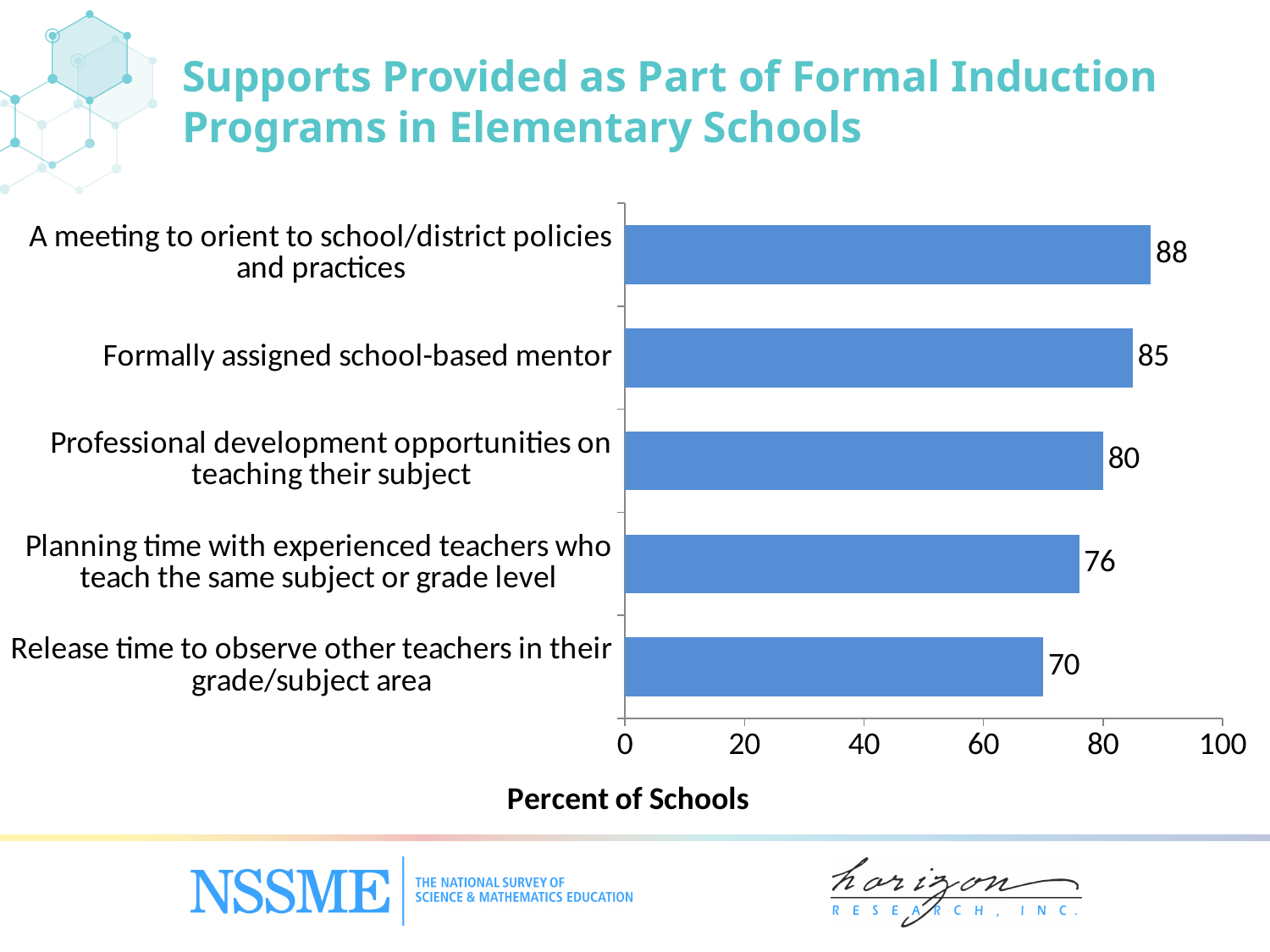
How many supports (categories) are shown in the chart? 5 What kind of chart is shown on the slide? Bar chart What percent of schools provide a formally assigned school-based mentor as part of formal induction programs? 85 What is the label of the horizontal axis? Percent of Schools Which is larger: the value for 'Professional development opportunities on teaching their subject' or the value for 'Planning time with experienced teachers who teach the same subject or grade level'? Professional development opportunities on teaching their subject What is the value for 'Release time to observe other teachers in their grade/subject area'? 70 What is the difference between the value for 'A meeting to orient to school/district policies and practices' and the value for 'Release time to observe other teachers in their grade/subject area'? 18 Which support has the highest percent of schools? A meeting to orient to school/district policies and practices Is the value for 'Planning time with experienced teachers who teach the same subject or grade level' greater or less than 80? less What is the difference between the value for 'Formally assigned school-based mentor' and the value for 'Planning time with experienced teachers who teach the same subject or grade level'? 9 What percent of schools provide professional development opportunities on teaching their subject? 80 Which support has the lowest percent of schools? Release time to observe other teachers in their grade/subject area